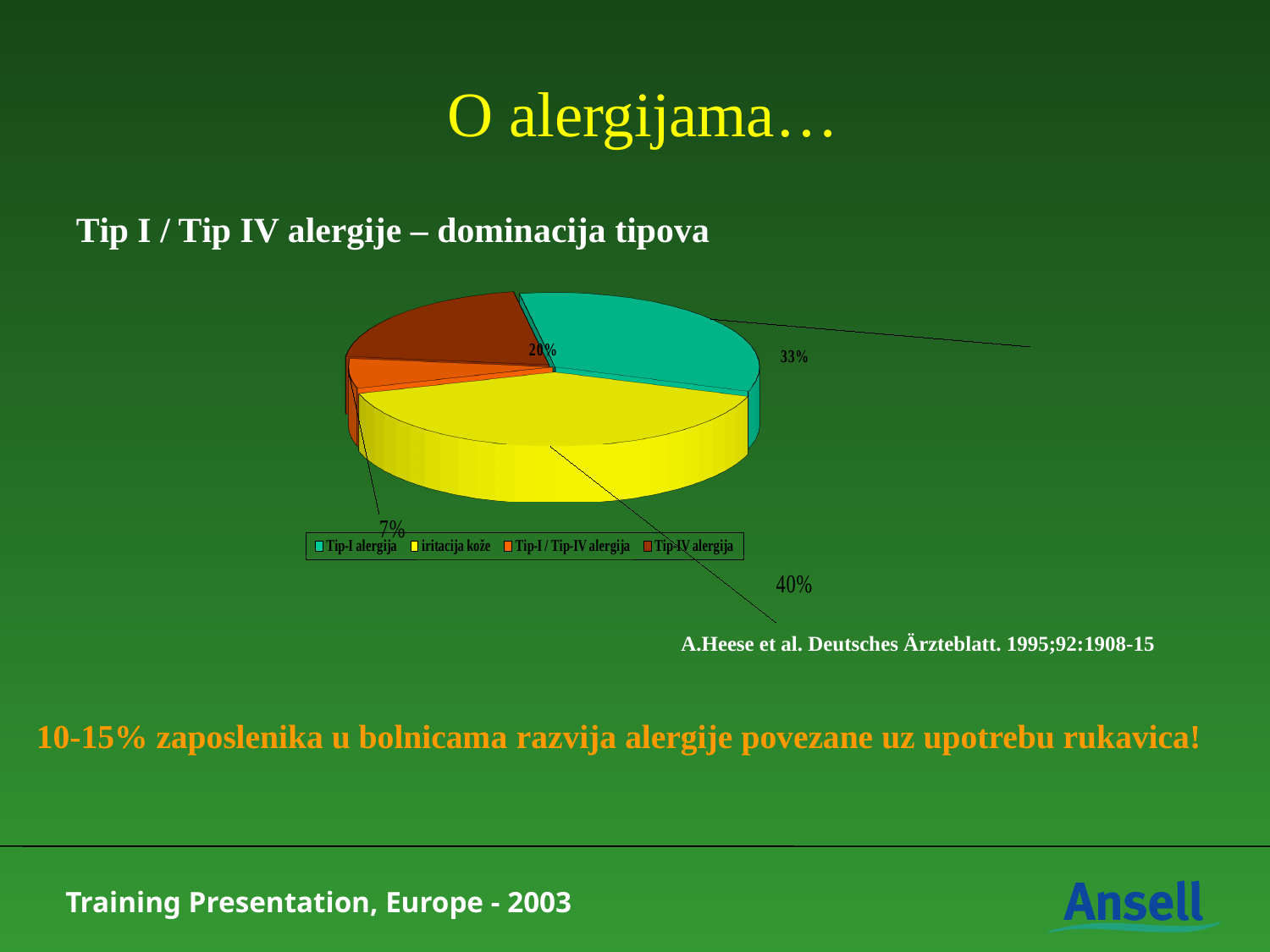
What share of the pie is labelled for 'Tip-IV alergija'? 20% What share of the pie is labelled for 'Tip-I / Tip-IV alergija'? 7% What kind of chart is shown on the slide? pie chart Which category has the largest slice of the pie? iritacija kože What share of the pie is labelled for 'Tip-I alergija'? 33% How many entries does the legend of the pie chart list? 4 What is the difference in percentage points between 'iritacija kože' and 'Tip-I alergija'? 7% What colour is the slice for 'iritacija kože'? yellow How many slices does the pie chart have? 4 Which category has the smallest slice of the pie? Tip-I / Tip-IV alergija Which is larger, the slice for 'Tip-IV alergija' or the slice for 'Tip-I / Tip-IV alergija'? Tip-IV alergija